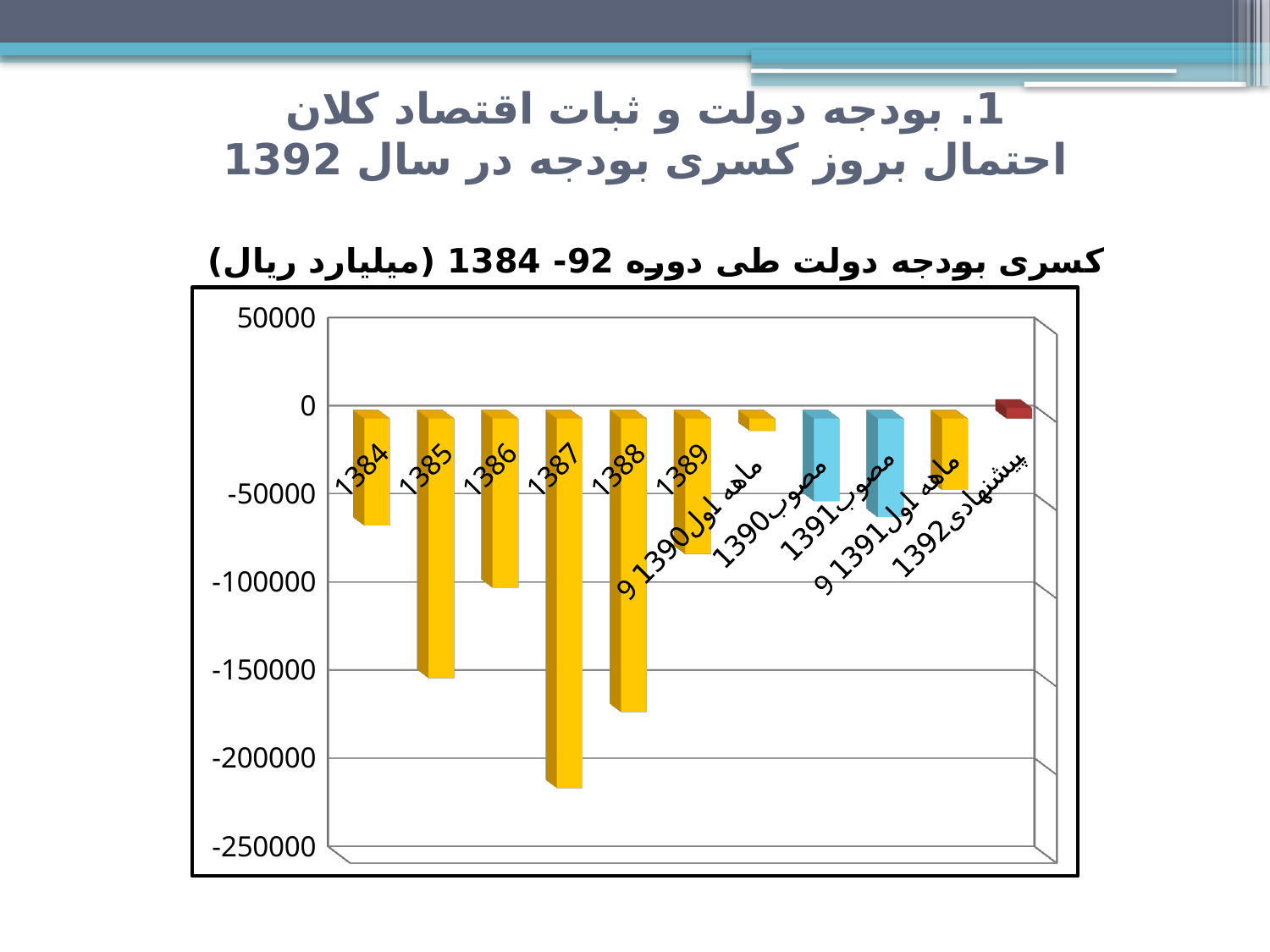
Is the value for 1387 greater or less than -200000? less Is the value for 1388 greater or less than -150000? less Which of 1384 and 1386 has the higher (less negative) value? 1384 Is the value for 9 ماهه اول 1390 greater or less than -50000? greater How many categories are plotted along the x axis of the chart? 11 What colour is the bar for پیشنهادی 1392? red Which of 1385 and 1387 has the more negative value? 1387 What kind of chart is shown on the slide? bar chart Which category has the highest value in the chart? پیشنهادی 1392 Which category has the lowest (most negative) value in the chart? 1387